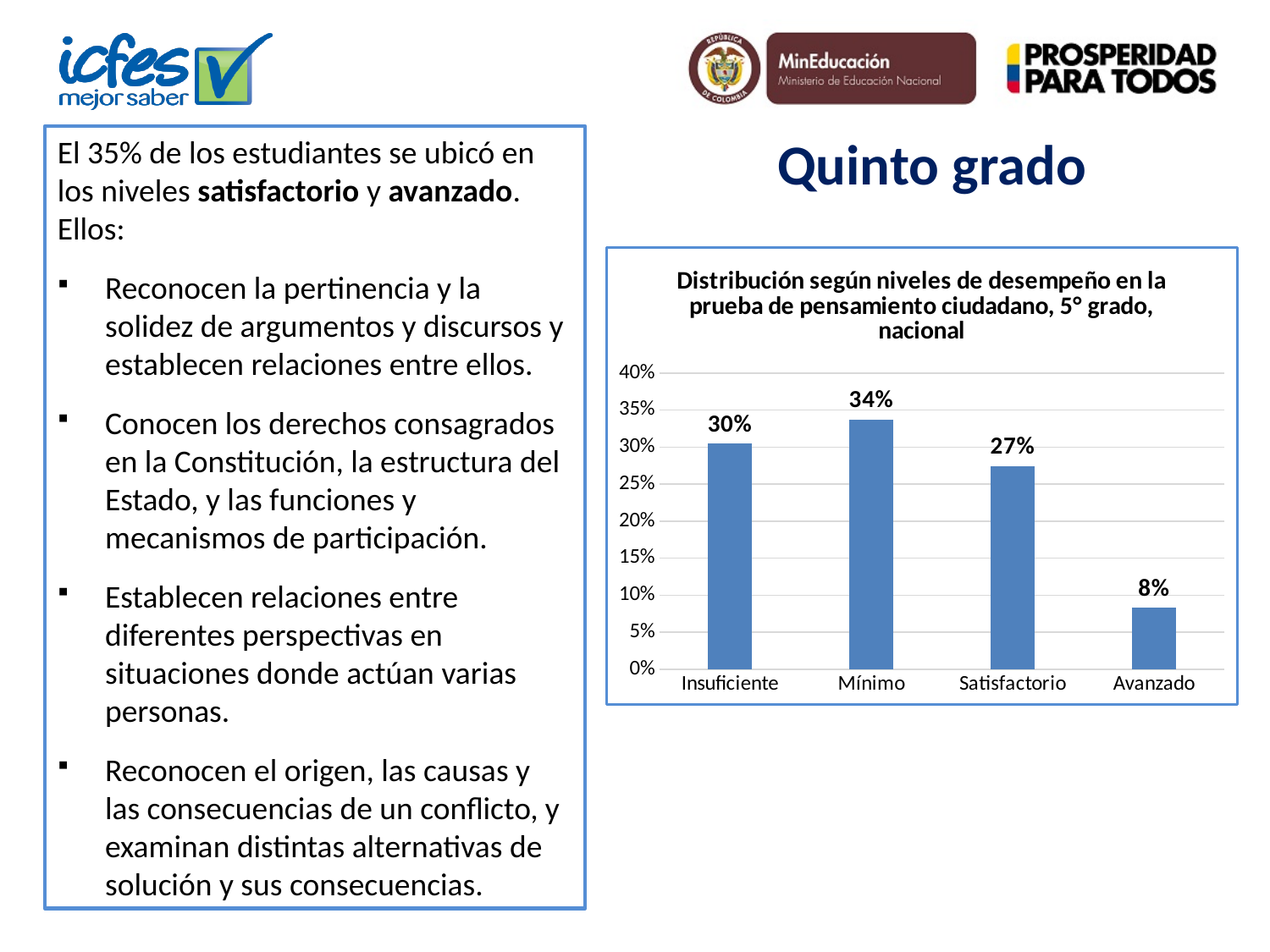
Which category has the lowest value? Avanzado What is the value for Avanzado? 8% What is the value for Insuficiente? 30% Which is larger, the value for Insuficiente or the value for Satisfactorio? Insuficiente Which category has the highest value? Mínimo Is the value for Satisfactorio greater or less than 25%? greater What kind of chart is shown? bar chart What is the difference between the values for Mínimo and Satisfactorio? 7% What is the value for Mínimo? 34% What is the combined value of Satisfactorio and Avanzado? 35% How many categories are shown on the x axis? 4 What is the title of the chart? Distribución según niveles de desempeño en la prueba de pensamiento ciudadano, 5° grado, nacional